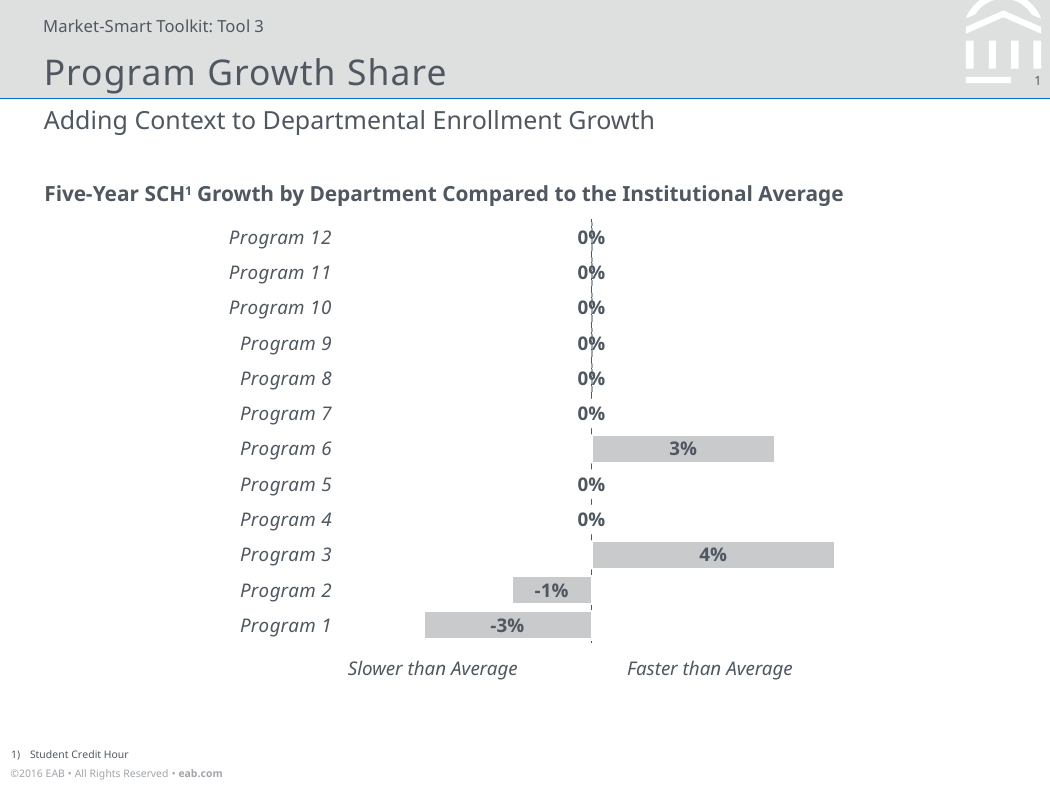
What is the value for Program 6? 3% Which has a larger value, Program 6 or Program 2? Program 6 What kind of chart is shown on the slide? Bar chart What is the value for Program 1? -3% What is the difference between the values for Program 3 and Program 6? 1% How many programs are shown in the chart? 12 What label appears on the right side below the chart? Faster than Average What is the value for Program 3? 4% Which program has the lowest value? Program 1 What is the value for Program 2? -1% Which program has the highest value? Program 3 What is the title of the chart? Five-Year SCH Growth by Department Compared to the Institutional Average